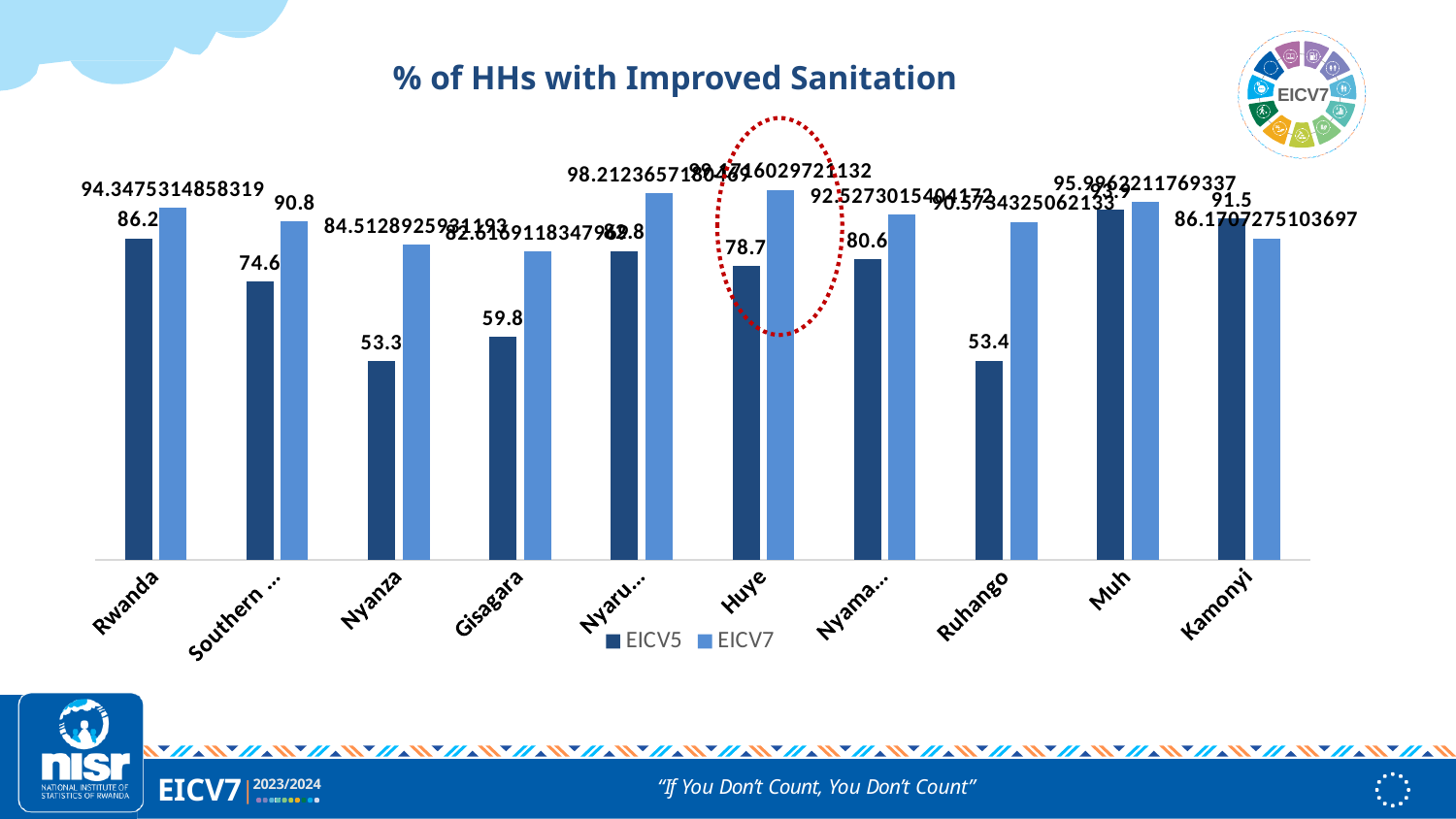
Which has the larger EICV5 value, Huye or Nyama...? Nyama... What is the title of the chart? % of HHs with Improved Sanitation What is the EICV5 value for Rwanda? 86.2 What is the EICV5 value for Ruhango? 53.4 For Kamonyi, which series has the larger value, EICV5 or EICV7? EICV5 What is the difference between the EICV5 values for Gisagara and Nyanza? 6.5 What is the difference between the EICV7 and EICV5 values for Southern ...? 16.2 What is the EICV5 value for Huye? 78.7 What is the EICV7 value for Southern ...? 90.8 How many categories are shown on the x axis? 10 Which category has the highest EICV5 value? Muh How many series does the legend list? 2